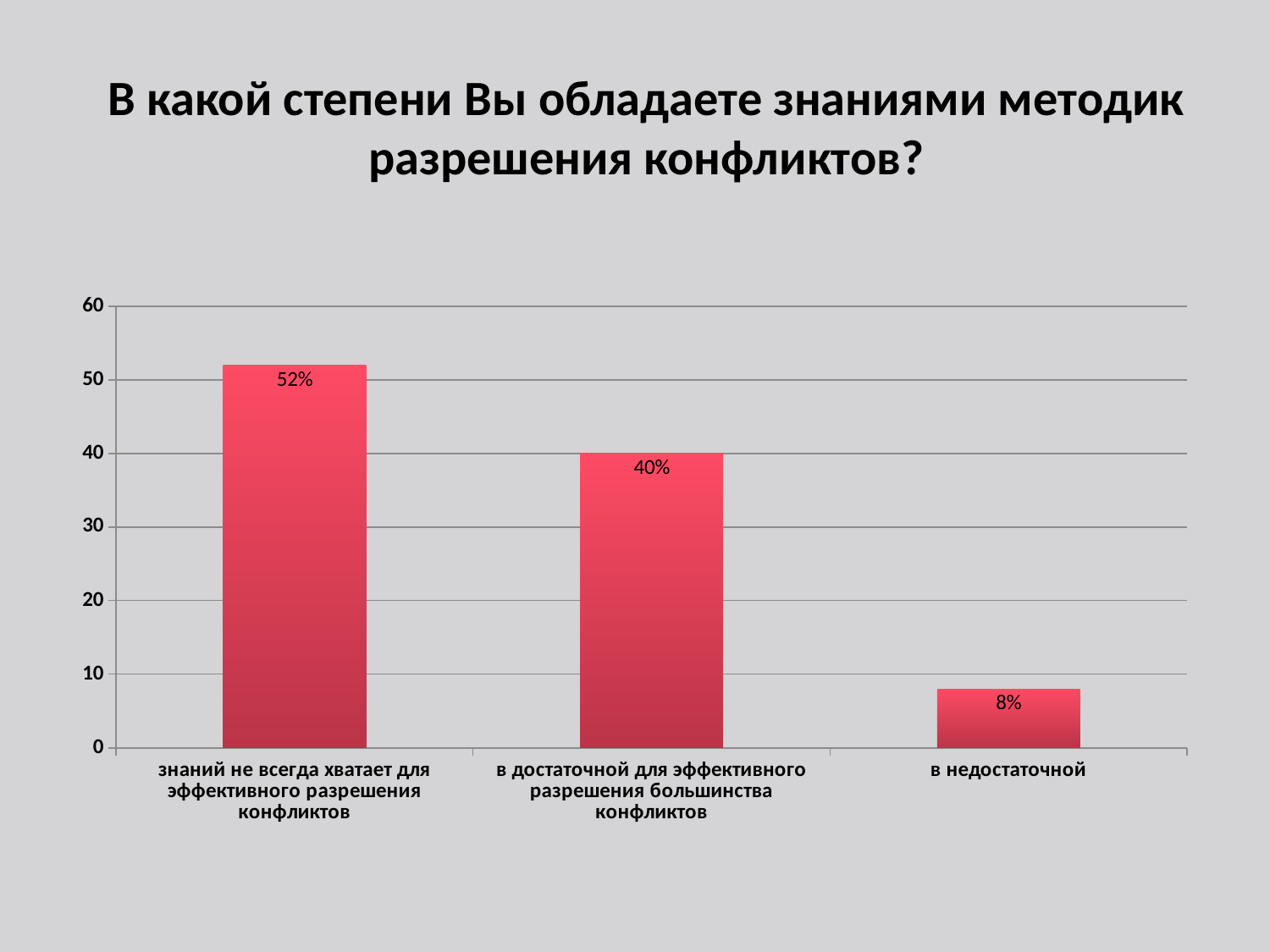
Is the value for "в недостаточной" greater or less than 10? less What is the title of the slide? В какой степени Вы обладаете знаниями методик разрешения конфликтов? What is the difference between the values for "в достаточной для эффективного разрешения большинства конфликтов" and "в недостаточной"? 32% What is the difference between the values for "знаний не всегда хватает для эффективного разрешения конфликтов" and "в достаточной для эффективного разрешения большинства конфликтов"? 12% Which category has the highest value? знаний не всегда хватает для эффективного разрешения конфликтов What kind of chart is shown on the slide? bar chart Which category has the lowest value? в недостаточной What is the value for "в недостаточной"? 8% What is the value for "знаний не всегда хватает для эффективного разрешения конфликтов"? 52% What is the value for "в достаточной для эффективного разрешения большинства конфликтов"? 40% How many categories are shown on the x axis? 3 Which is larger: the value for "в достаточной для эффективного разрешения большинства конфликтов" or for "в недостаточной"? в достаточной для эффективного разрешения большинства конфликтов